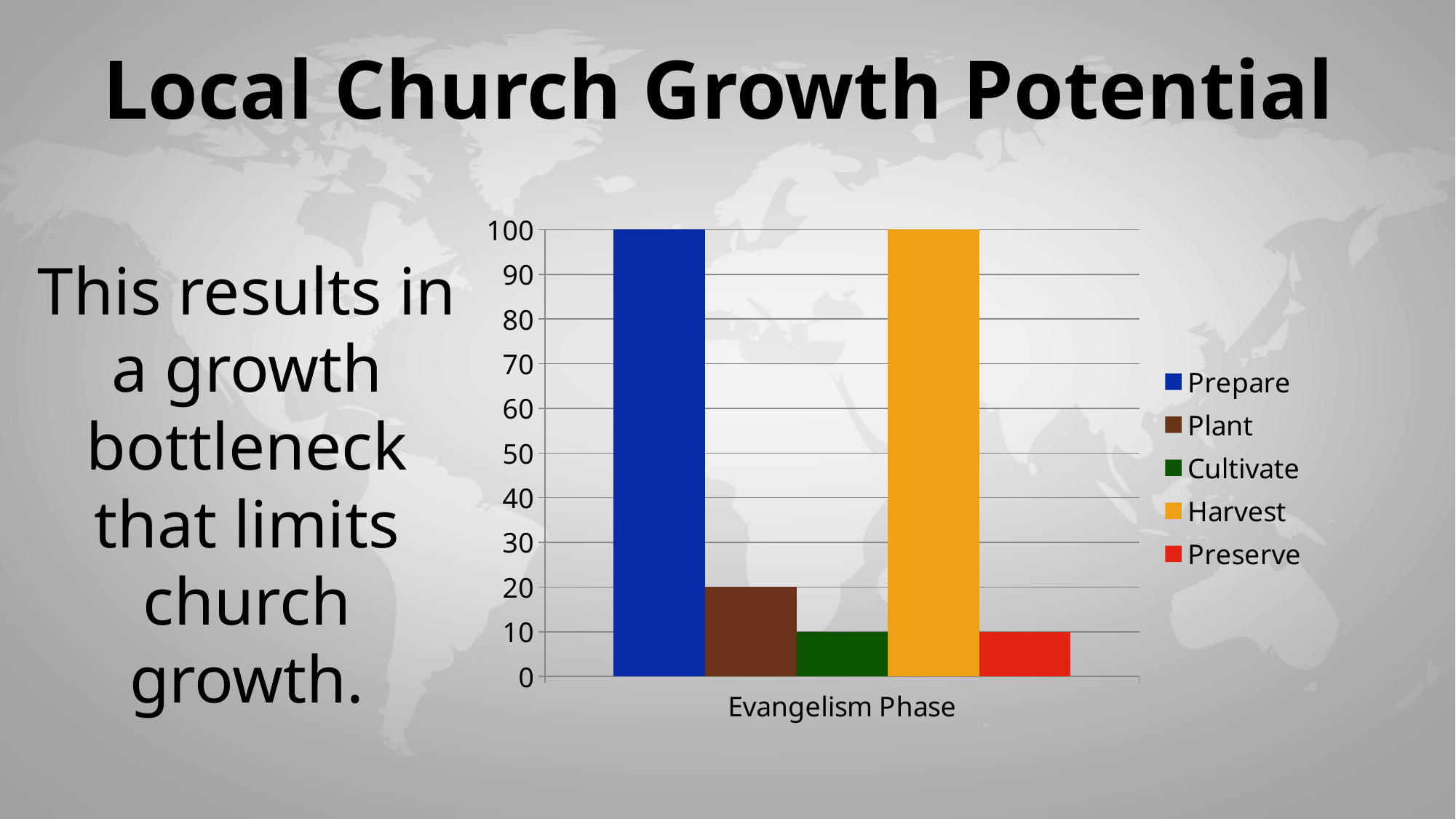
How many series does the legend list? 5 What kind of chart is shown on the slide? bar chart What is the value of the Cultivate series in the chart? 10 What is the difference between the Prepare value and the Plant value? 80 Which is larger, the Harvest value or the Preserve value? Harvest Is the value for Plant greater or less than 50? less What is the value of the Plant series in the chart? 20 What is the value of the Prepare series in the chart? 100 What is the value of the Harvest series in the chart? 100 What is the difference between the Plant value and the Cultivate value? 10 What is the label on the x axis of the chart? Evangelism Phase What is the value of the Preserve series in the chart? 10